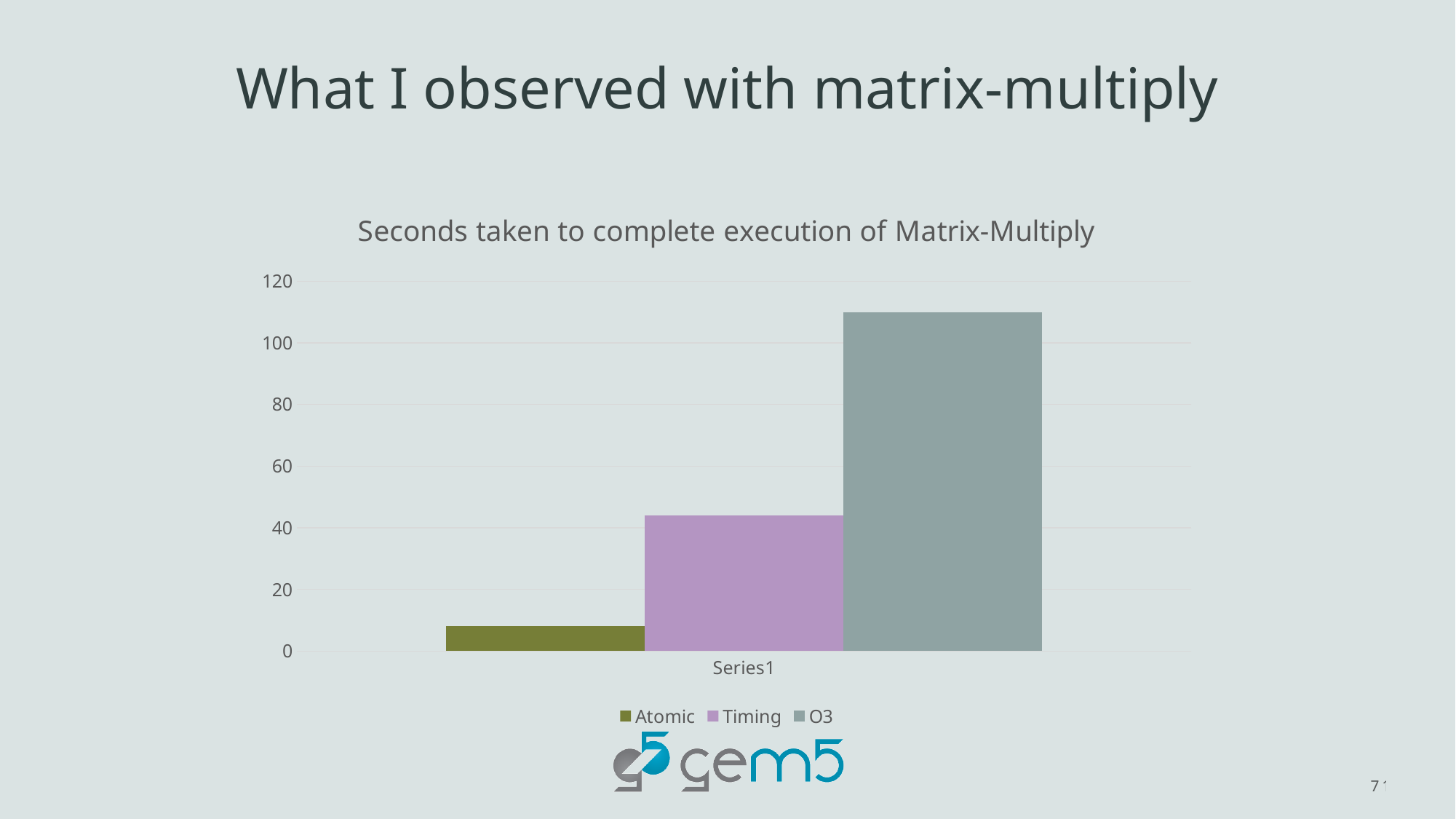
Which series has the highest value? O3 How many series does the legend list? 3 Is the value for O3 greater or less than 100? greater What is the label on the x axis under the bars? Series1 Which series has the lowest value? Atomic Is the value for Atomic greater or less than 20? less Which is larger, the value for Timing or the value for Atomic? Timing What is the title of the chart? Seconds taken to complete execution of Matrix-Multiply Which is larger, the value for O3 or the value for Timing? O3 What kind of chart is shown on the slide? bar chart Is the value for Timing greater or less than 60? less